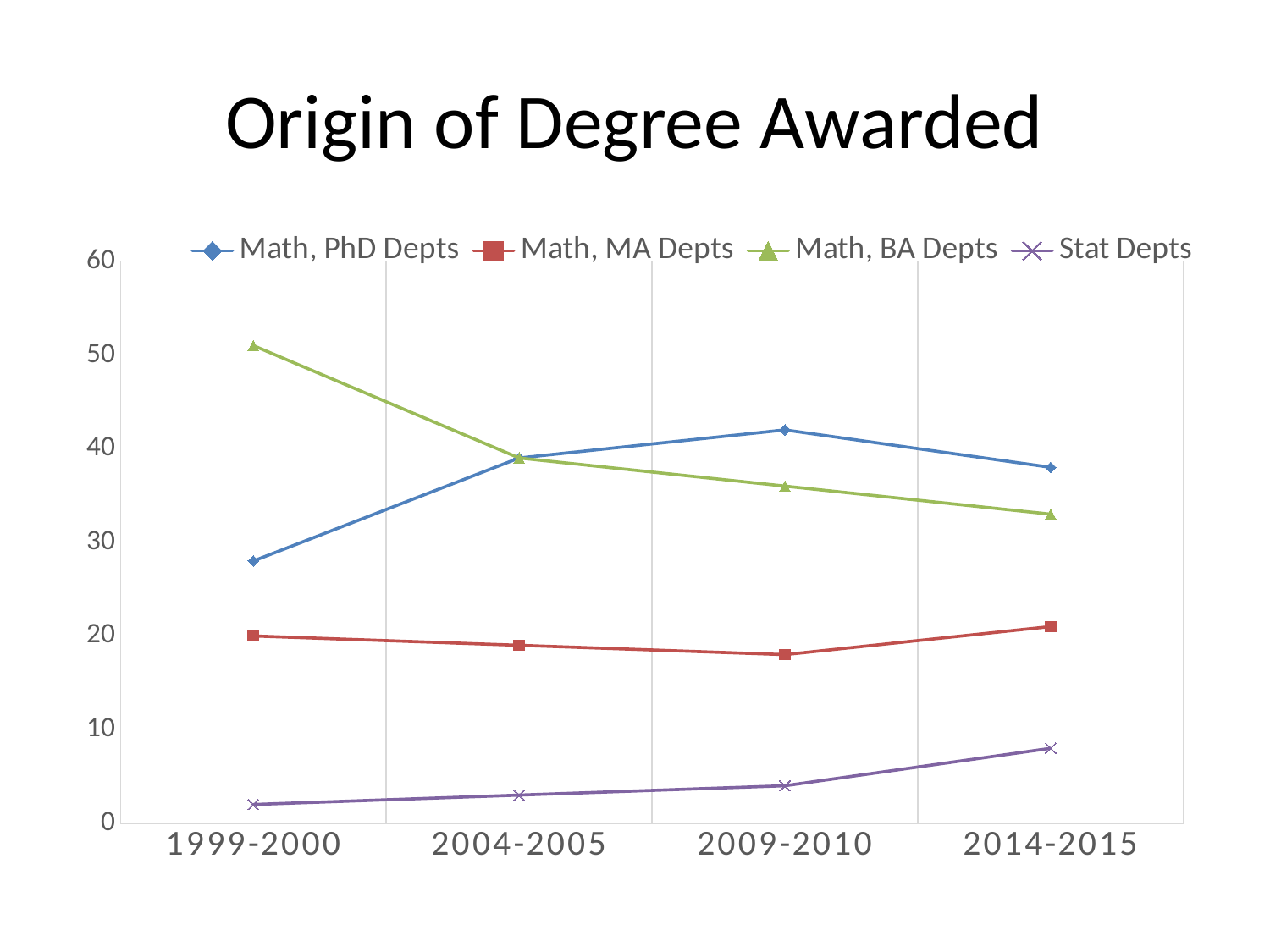
How many time periods are plotted along the x axis? 4 Do the values for Math, BA Depts rise or fall from 1999-2000 to 2014-2015? fall Which series has the lowest value in 2014-2015? Stat Depts Do the values for Stat Depts rise or fall from 1999-2000 to 2014-2015? rise In 2009-2010, which is larger: Math, PhD Depts or Math, BA Depts? Math, PhD Depts Which series has the highest value in 1999-2000? Math, BA Depts Is the value for Stat Depts in 2014-2015 greater or less than 10? less What kind of chart is shown on the slide? line chart Is the value for Math, MA Depts in 2009-2010 greater or less than 20? less Is the value for Math, BA Depts in 1999-2000 greater or less than 40? greater How many series does the legend list? 4 In which period does Math, PhD Depts reach its highest value? 2009-2010